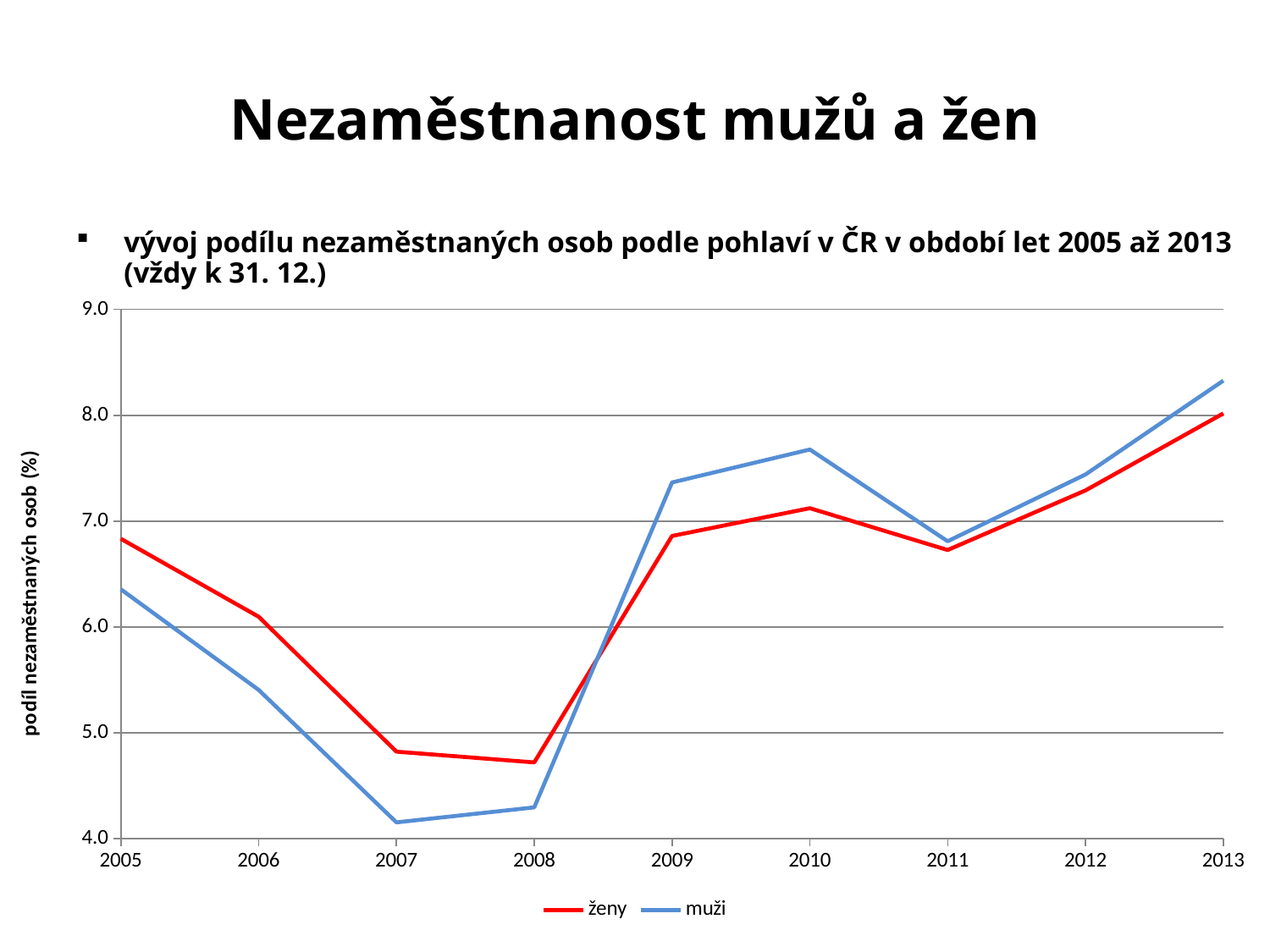
What kind of chart is shown on the slide? line chart How many years are plotted along the x axis? 9 In 2007, which series has the larger value, ženy or muži? ženy Is the value for muži in 2007 greater or less than 5.0? less In which year is the value for muži highest? 2013 In which year is the value for muži lowest? 2007 In which year is the value for ženy highest? 2013 How many series does the legend list? 2 Which series is drawn in red? ženy In 2010, which series has the larger value, ženy or muži? muži Is the value for muži in 2013 greater or less than 8.0? greater Do the values for ženy rise or fall from 2005 to 2007? fall